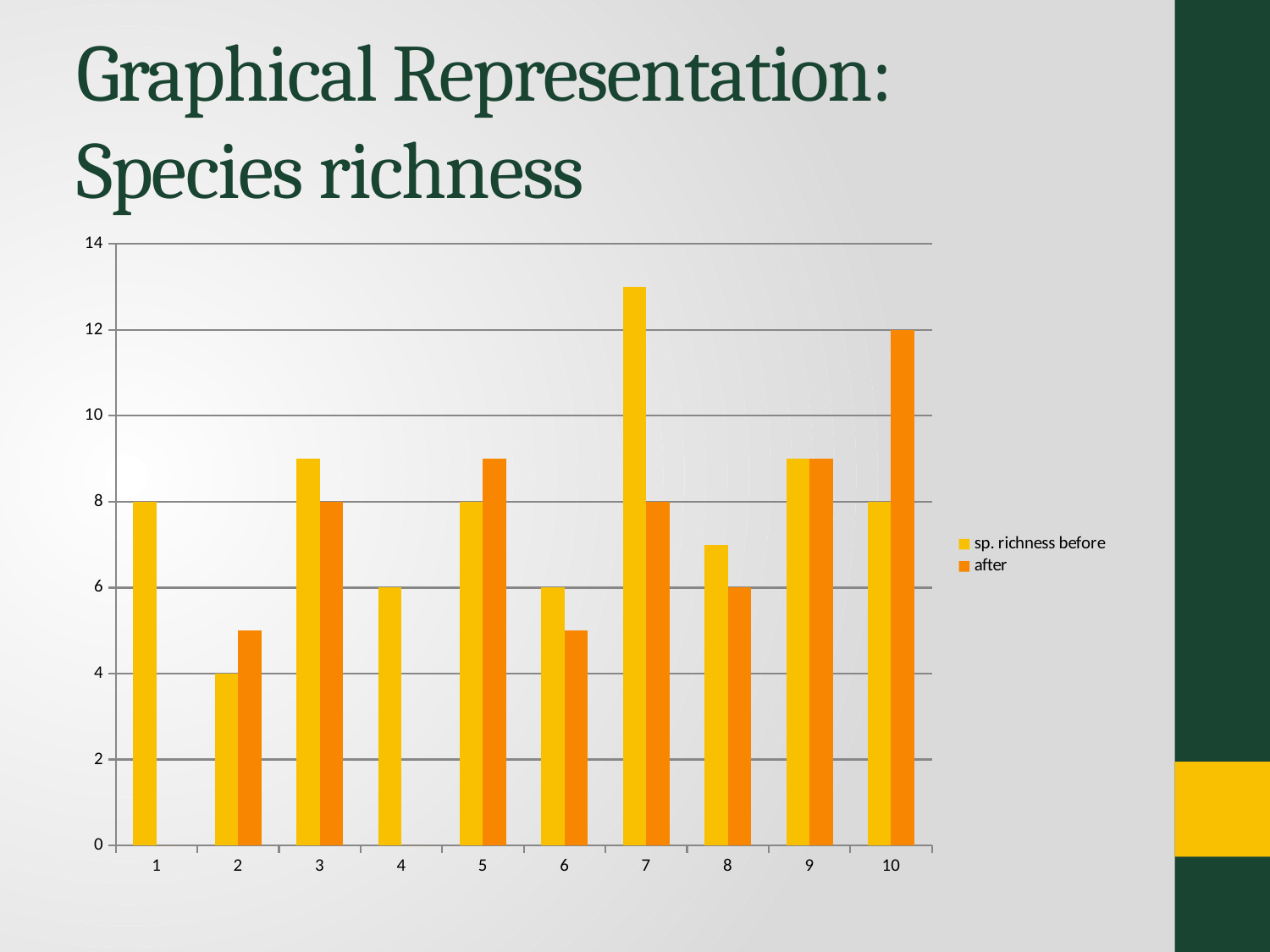
What is the 'sp. richness before' value for category 1? 8 What is the 'sp. richness before' value for category 2? 4 Which category has the highest 'sp. richness before' value? 7 What is the 'after' value for category 10? 12 Which category has the lowest 'sp. richness before' value? 2 How many series does the legend list? 2 What kind of chart is shown on the slide? bar chart Which category has the highest 'after' value? 10 How many categories are shown on the x axis? 10 For category 10, which is larger: 'sp. richness before' or 'after'? after What is the difference between the 'after' and 'sp. richness before' values for category 10? 4 Is the 'sp. richness before' value for category 7 greater or less than 12? greater